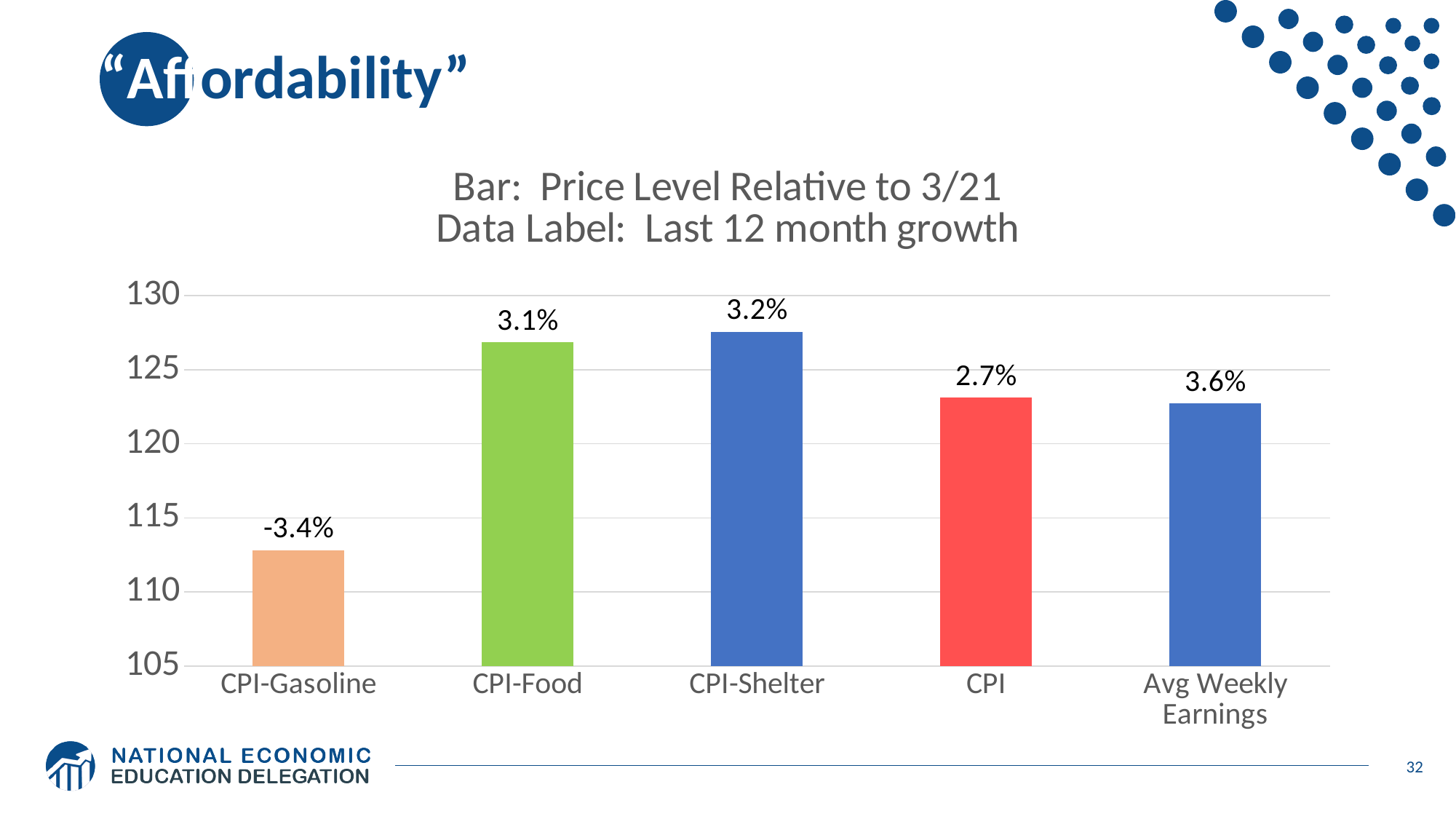
What is the data label (last 12 month growth) shown for CPI-Gasoline? -3.4% Which category has the highest last 12 month growth data label? Avg Weekly Earnings Is the bar for CPI-Food greater or less than 125? greater Which bar is taller, CPI-Food or CPI? CPI-Food What is the data label shown for CPI-Food? 3.1% How many categories are shown on the x axis? 5 Which category has the lowest last 12 month growth data label? CPI-Gasoline What is the data label shown for CPI-Shelter? 3.2% What is the data label shown for Avg Weekly Earnings? 3.6% Which bar is the tallest (highest price level relative to 3/21)? CPI-Shelter What is the difference between the data labels for Avg Weekly Earnings and CPI? 0.9% Is the bar for CPI-Gasoline greater or less than 115? less